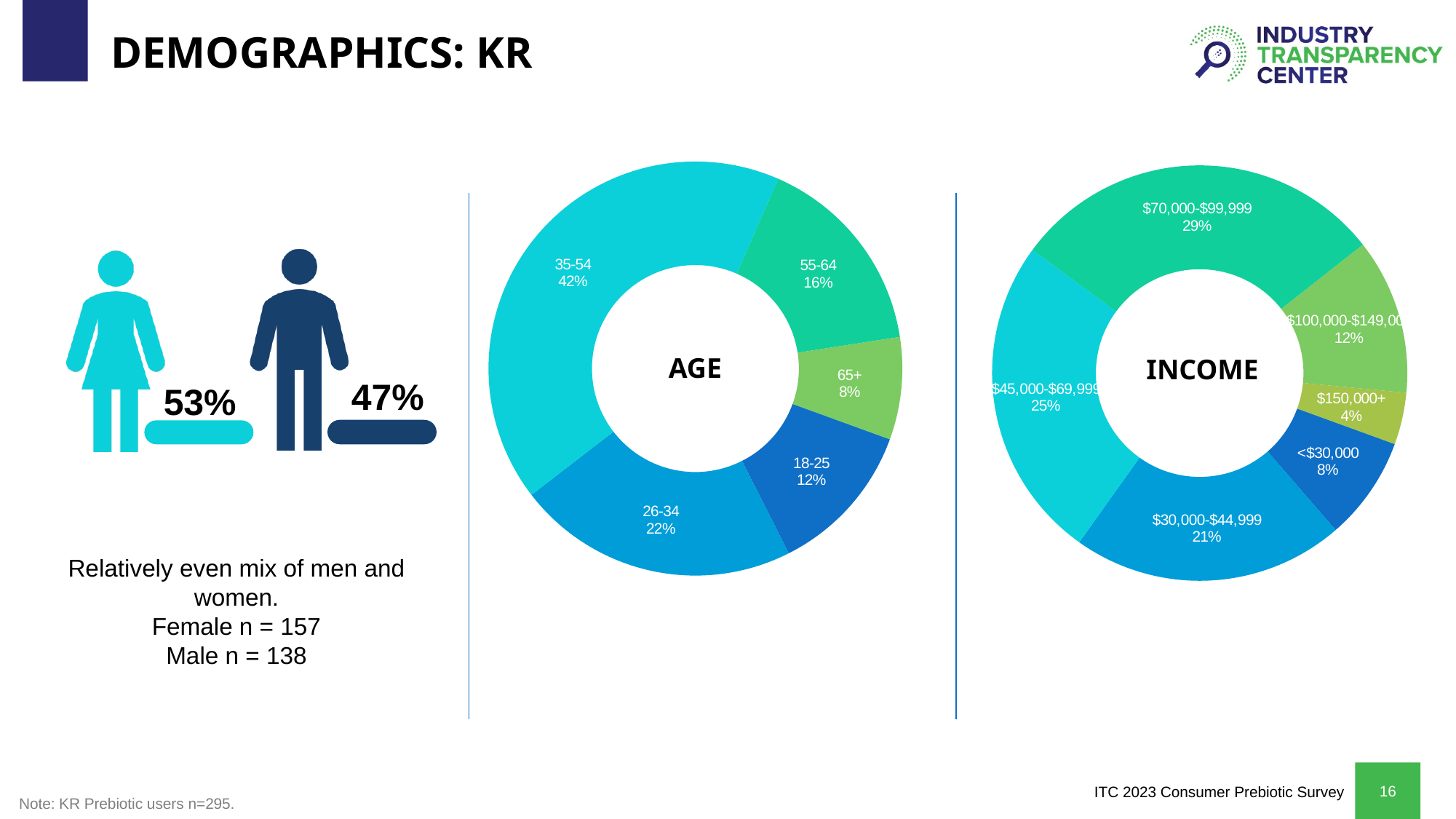
In the AGE chart, what share of respondents are aged 18-25? 12% In the AGE chart, how many age groups are shown? 5 In the INCOME chart, what share of respondents earn $70,000-$99,999? 29% In the INCOME chart, how many income brackets are shown? 6 In the AGE chart, which age group has the smallest share? 65+ In the INCOME chart, what share of respondents earn $150,000+? 4% What kind of chart is the AGE chart? Doughnut chart In the AGE chart, which age group has the largest share? 35-54 In the AGE chart, what share of respondents are aged 35-54? 42% In the INCOME chart, which income bracket has the largest share? $70,000-$99,999 In the INCOME chart, which is larger: the share for $45,000-$69,999 or the share for $30,000-$44,999? $45,000-$69,999 In the AGE chart, what is the difference in percentage points between the 26-34 and 55-64 groups? 6